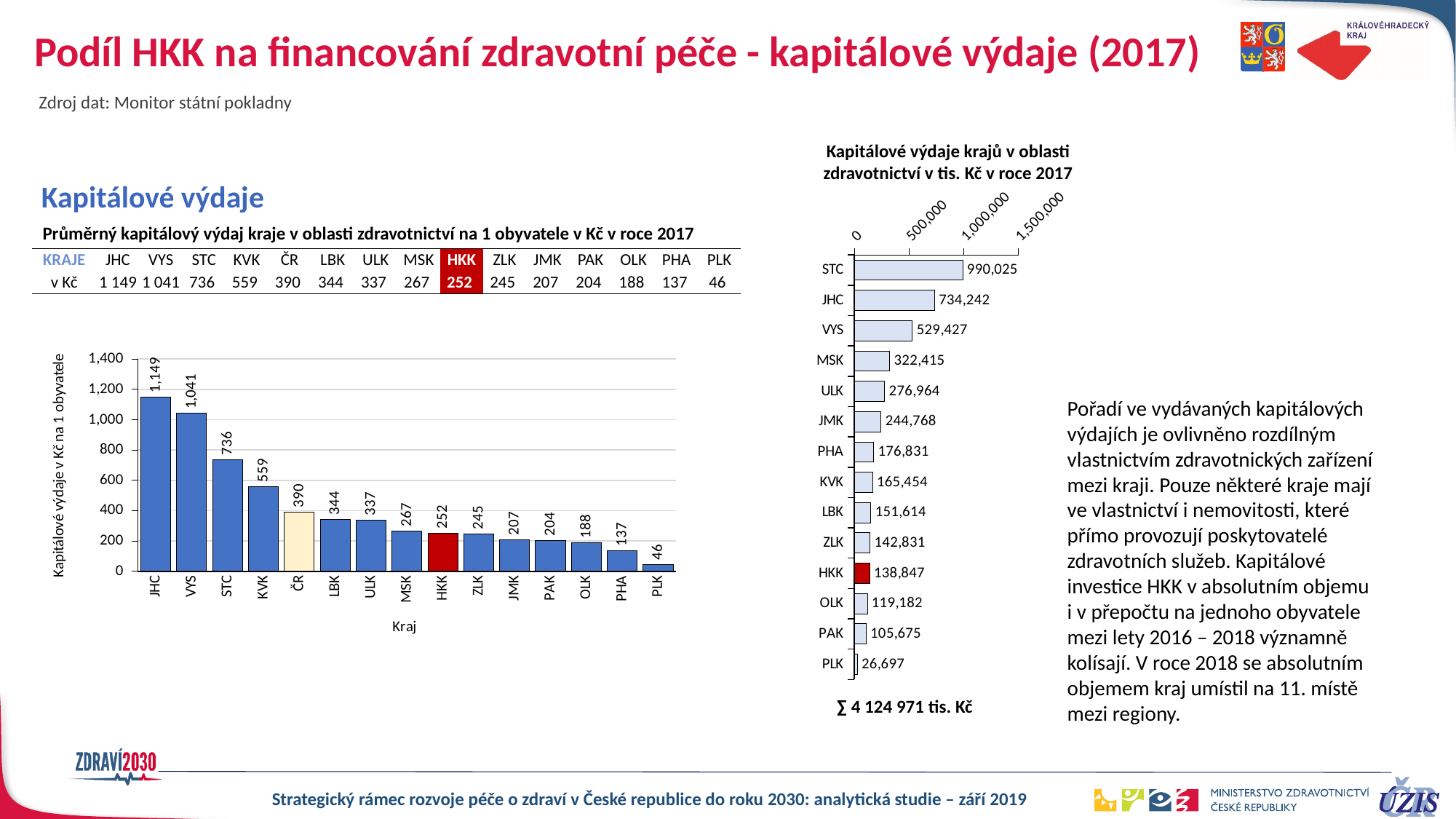
In the left chart (capital expenditure per inhabitant), which region has the lowest value? PLK In the right chart (Kapitálové výdaje krajů v oblasti zdravotnictví v tis. Kč v roce 2017), which is larger, the value for MSK or the value for ULK? MSK What kind of chart is the right chart (Kapitálové výdaje krajů v oblasti zdravotnictví v tis. Kč v roce 2017)? bar chart In the right chart (Kapitálové výdaje krajů v oblasti zdravotnictví v tis. Kč v roce 2017), which region has the highest value? STC In the left chart (capital expenditure per inhabitant), what is the value for ČR? 390 In the left chart (capital expenditure per inhabitant), do the values rise or fall from left to right along the x axis? fall In the left chart (capital expenditure per inhabitant), how many bars are plotted? 15 In the right chart (Kapitálové výdaje krajů v oblasti zdravotnictví v tis. Kč v roce 2017), what is the value for HKK? 138,847 In the left chart (capital expenditure per inhabitant), what is the value for HKK? 252 In the left chart (capital expenditure per inhabitant), what is the difference between the values for JHC and VYS? 108 In the left chart (capital expenditure per inhabitant), which region has the highest value? JHC In the right chart (Kapitálové výdaje krajů v oblasti zdravotnictví v tis. Kč v roce 2017), how many regions are plotted? 14